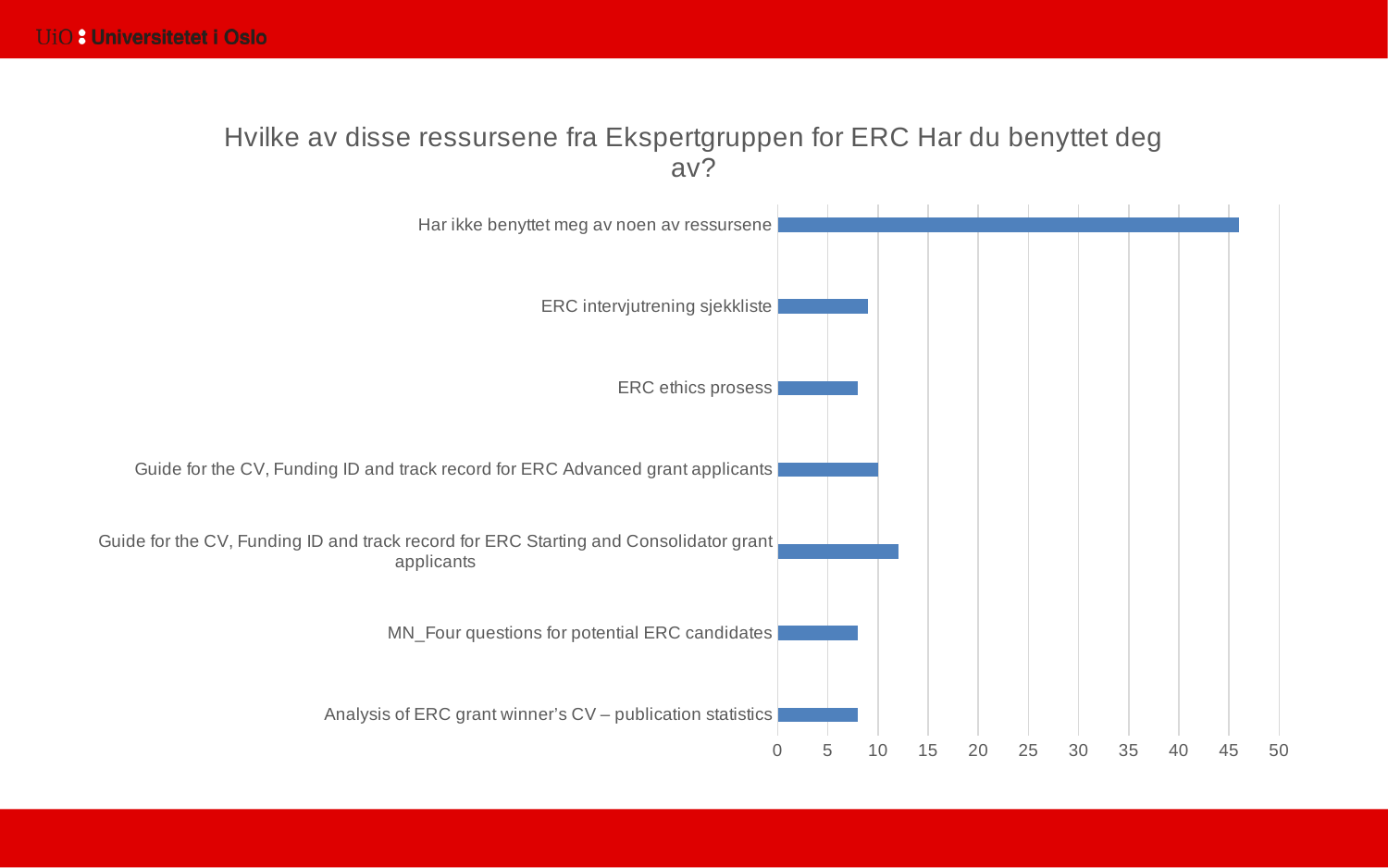
Which is larger: the value for "Guide for the CV, Funding ID and track record for ERC Starting and Consolidator grant applicants" or the value for "ERC ethics prosess"? Guide for the CV, Funding ID and track record for ERC Starting and Consolidator grant applicants Is the value for "Har ikke benyttet meg av noen av ressursene" greater or less than 40? greater How many categories are shown in the chart? 7 Is the value for "MN_Four questions for potential ERC candidates" greater or less than 10? less What kind of chart is shown on the slide? bar chart Which is larger: the value for "Har ikke benyttet meg av noen av ressursene" or the value for "Guide for the CV, Funding ID and track record for ERC Starting and Consolidator grant applicants"? Har ikke benyttet meg av noen av ressursene What is the title of the chart? Hvilke av disse ressursene fra Ekspertgruppen for ERC Har du benyttet deg av? Is the value for "ERC ethics prosess" greater or less than 10? less Which category has the highest value in the chart? Har ikke benyttet meg av noen av ressursene